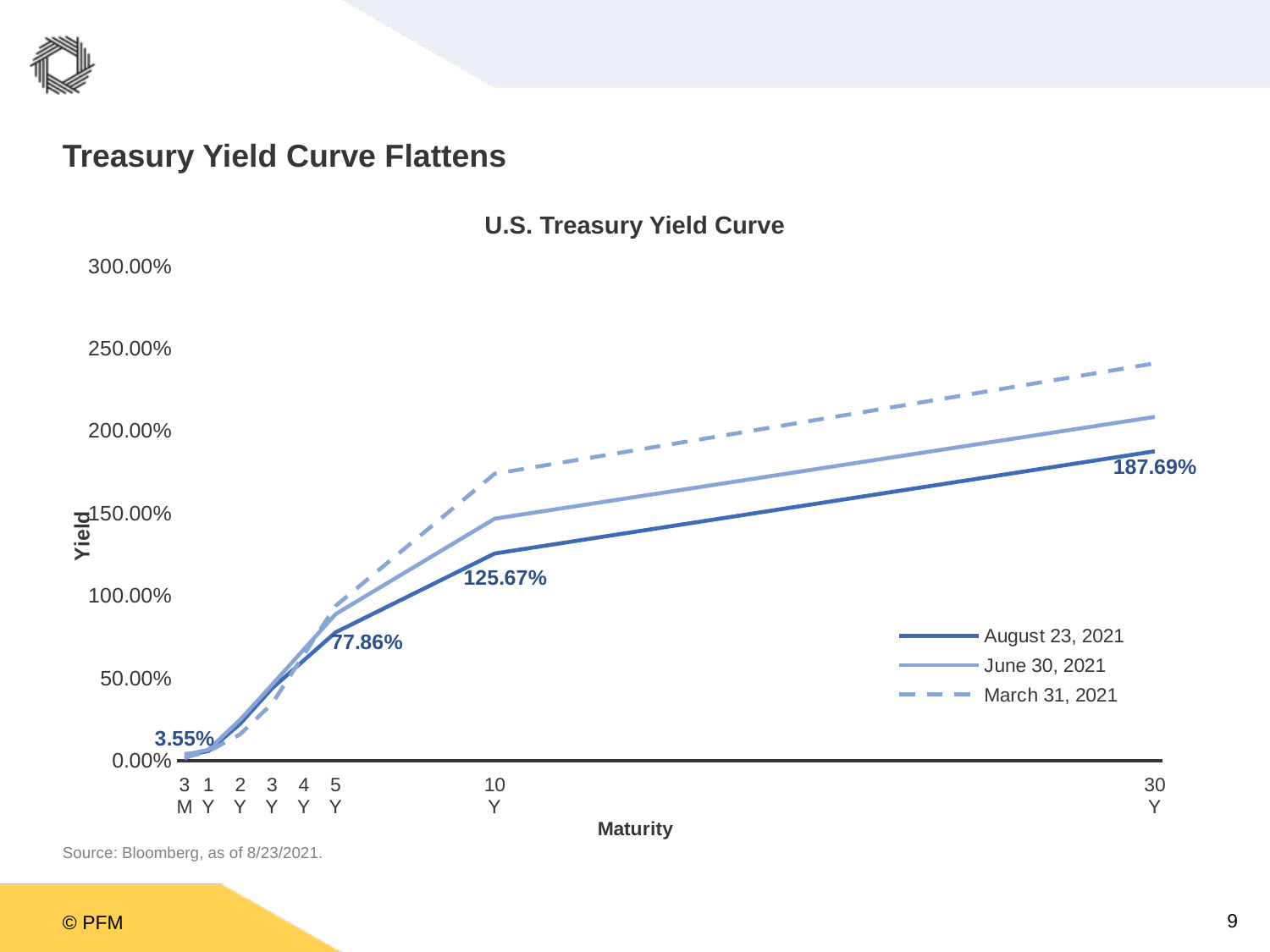
For the August 23, 2021 series, what is the difference between the 10 Y yield and the 5 Y yield? 47.81% Do the yields rise or fall as maturity increases along the x axis? Rise What is the yield for the August 23, 2021 series at the 5 Y maturity? 77.86% What kind of chart is shown on the slide? Line chart Is the March 31, 2021 yield at the 30 Y maturity greater or less than 200.00%? greater Which series has the highest yield at the 30 Y maturity? March 31, 2021 How many maturity categories are shown on the x axis? 8 For the August 23, 2021 series, what is the difference between the 30 Y yield and the 10 Y yield? 62.02% How many series does the legend list? 3 What is the yield for the August 23, 2021 series at the 30 Y maturity? 187.69% What is the yield for the August 23, 2021 series at the 3 M maturity? 3.55% What is the yield for the August 23, 2021 series at the 10 Y maturity? 125.67%